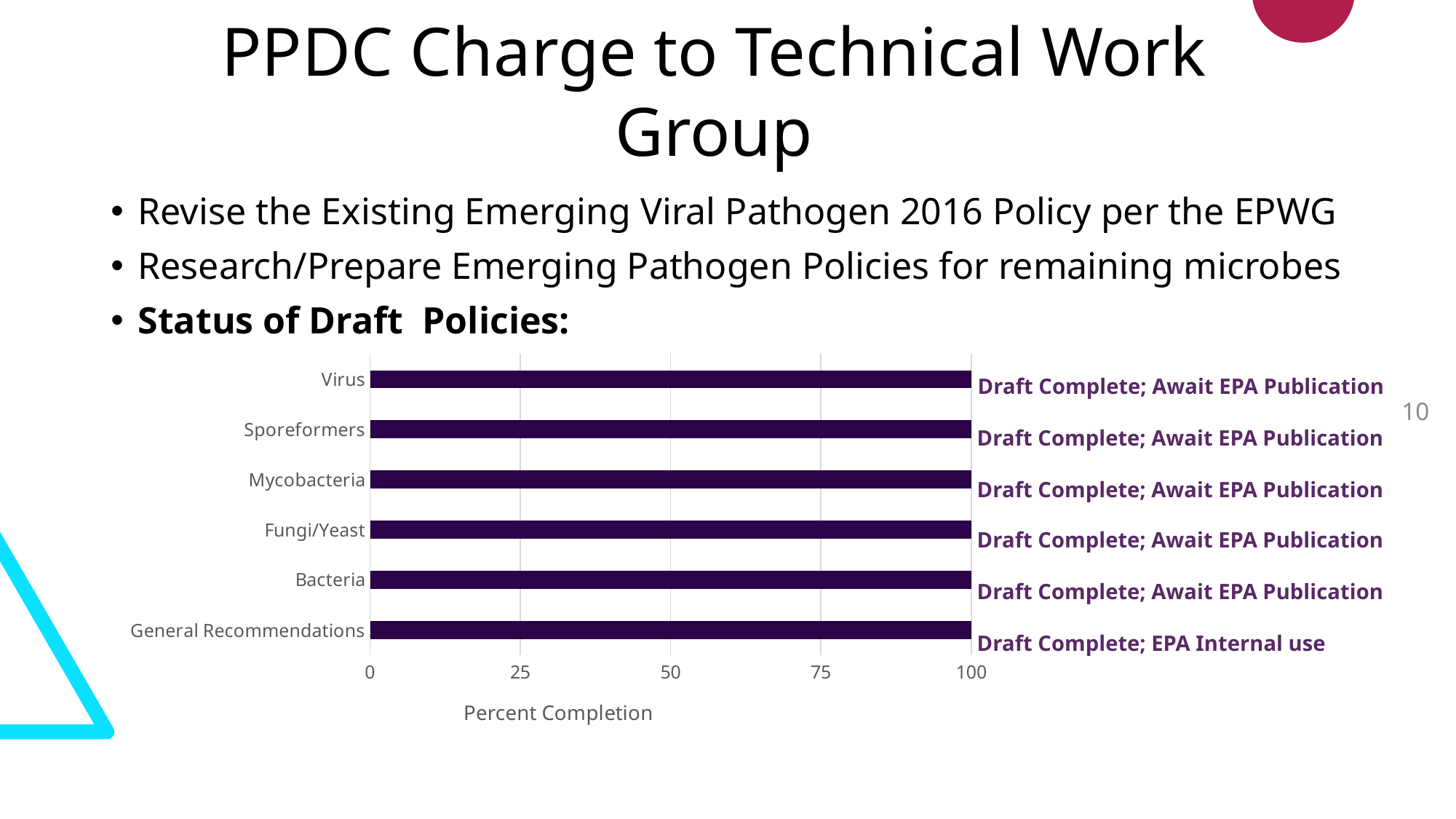
What is the label of the horizontal axis? Percent Completion What is the Percent Completion value for Mycobacteria? 100 What is the Percent Completion value for Virus? 100 Which category is listed at the top of the chart? Virus What is the difference between the values for Sporeformers and Bacteria? 0 How many categories are plotted in the chart? 6 Is the value for Fungi/Yeast greater or less than 50? greater What is the highest tick value shown on the horizontal axis? 100 What is the Percent Completion value for General Recommendations? 100 Is the value for Bacteria greater or less than 75? greater What status text is shown next to the General Recommendations bar? Draft Complete; EPA Internal use What kind of chart is shown on the slide? bar chart